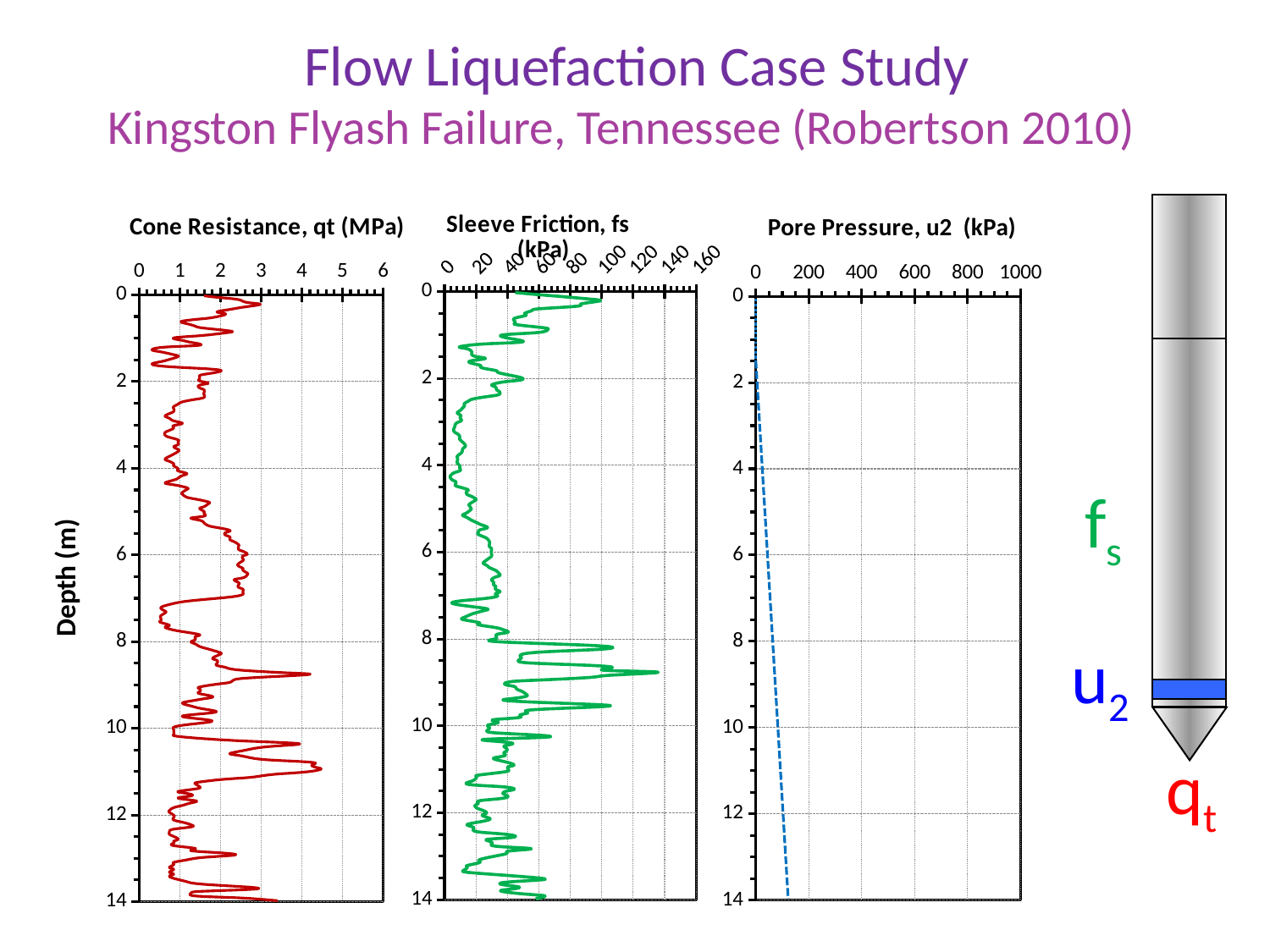
In the Cone Resistance, qt (MPa) chart, is the value at a depth of 6 m greater or less than 2 MPa? greater In the Pore Pressure, u2 (kPa) chart, is the value at a depth of 14 m greater or less than 200 kPa? less In the Cone Resistance, qt (MPa) chart, is the value at a depth of 2 m greater or less than 1 MPa? greater What is the label of the vertical axis shared by the charts? Depth (m) How many charts are plotted on the slide? 3 What kind of chart is the Cone Resistance, qt (MPa) chart? line chart What colour is the line in the Sleeve Friction, fs (kPa) chart? green In the Pore Pressure, u2 (kPa) chart, does the pore pressure increase or decrease as depth increases? increases